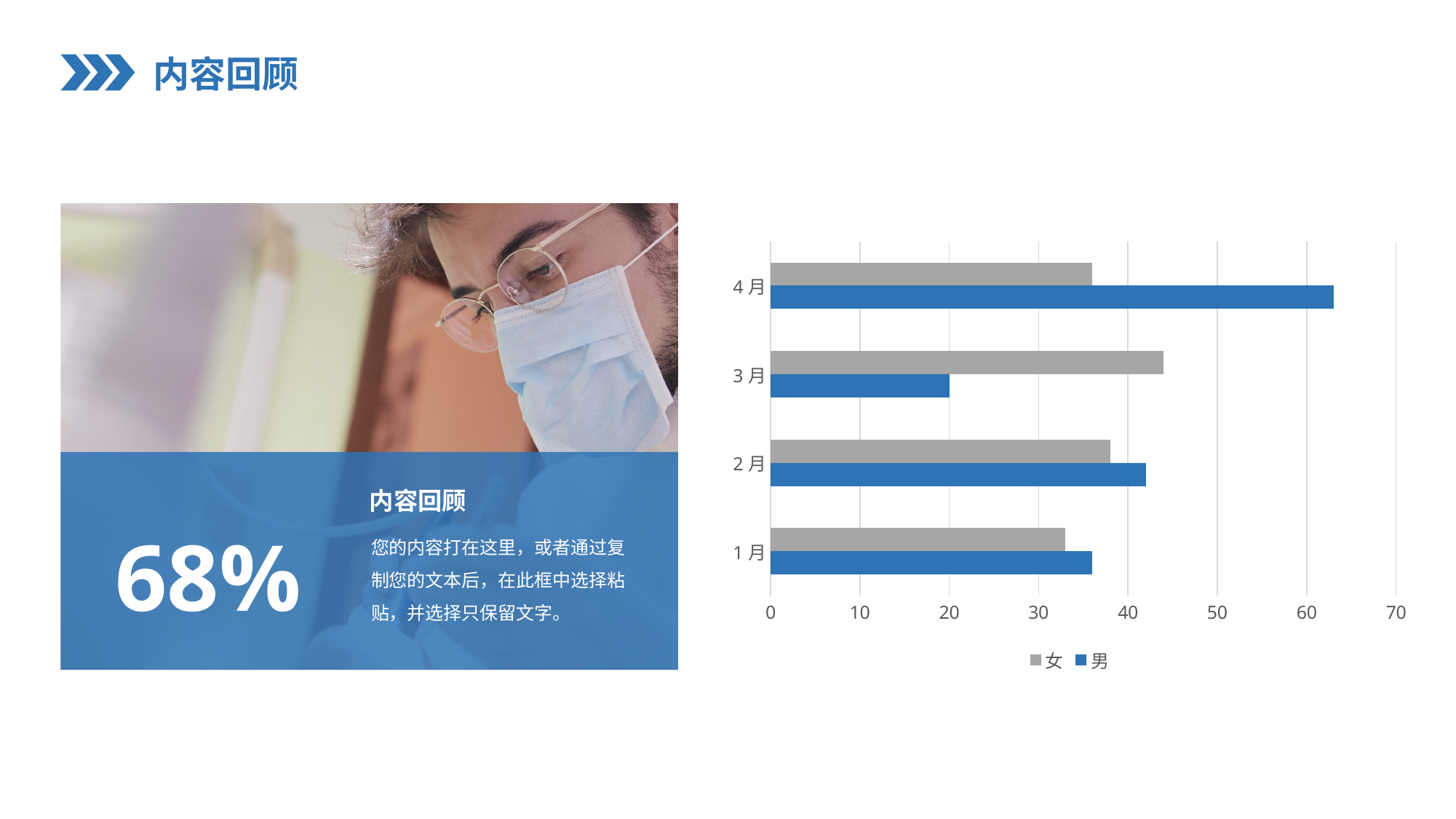
Is the value for 女 in 3月 greater or less than 40? greater How many series does the chart legend list? 2 Which month has the lowest value for 男? 3月 How many categories (months) are shown on the chart? 4 What kind of chart is shown on the slide? bar chart Which colour represents the 男 series in the chart? blue Is the value for 男 in 4月 greater or less than 60? greater Which month has the highest value for 男? 4月 Which month has the highest value for 女? 3月 Is the value for 男 in 3月 greater or less than 30? less In 4月, which series has the larger value, 女 or 男? 男 In 3月, which series has the larger value, 女 or 男? 女